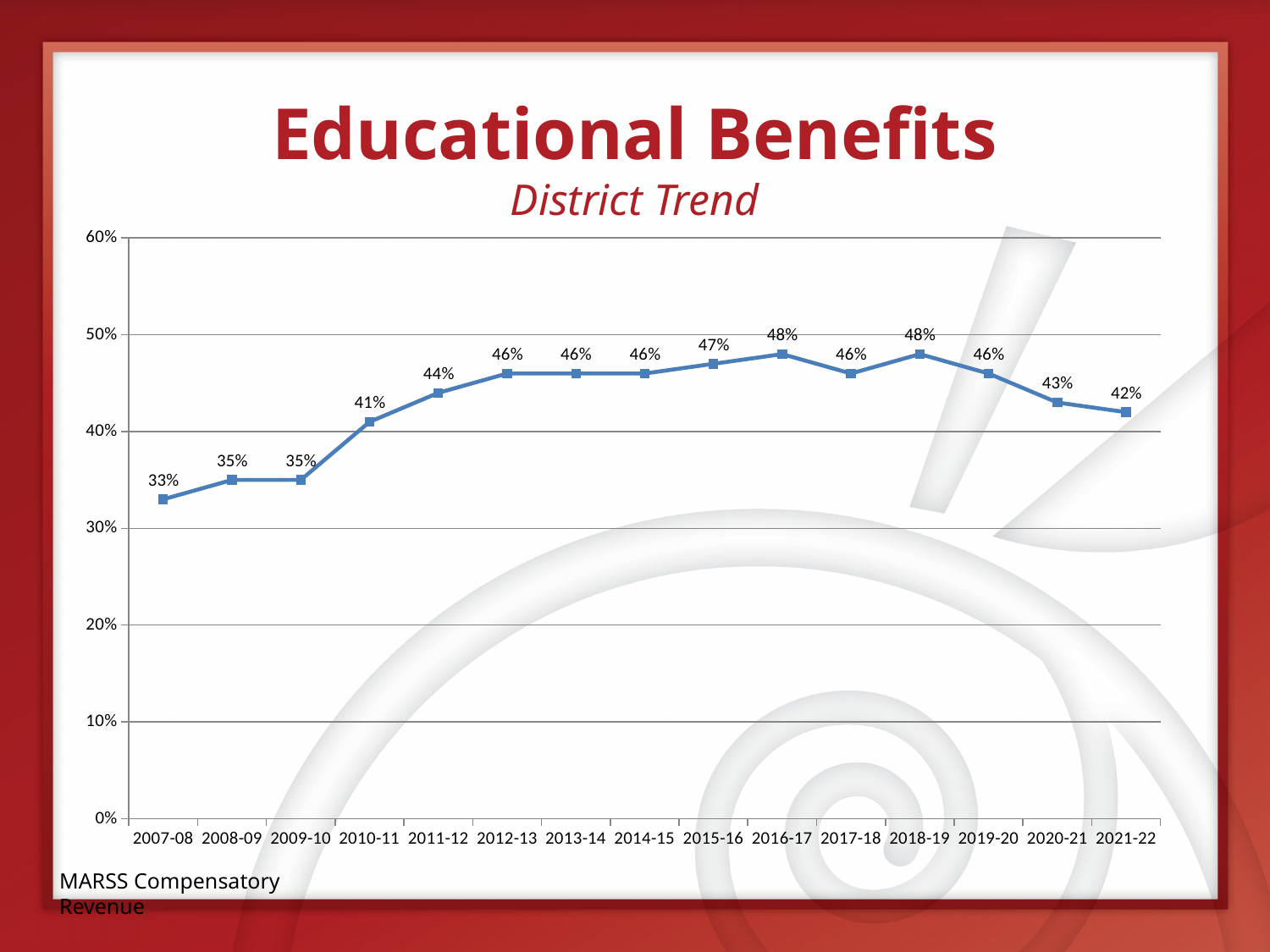
What is the value for 2010-11? 41% Do the values rise or fall from 2007-08 to 2011-12? Rise What is the value for 2021-22? 42% What is the subtitle of the chart below 'Educational Benefits'? District Trend What is the difference between the values for 2018-19 and 2021-22? 6% What is the value for 2016-17? 48% What is the value for 2007-08? 33% How many school years are plotted on the chart? 15 Which is larger, the value for 2011-12 or the value for 2020-21? 2011-12 What kind of chart is shown on the slide? Line chart What is the highest value shown on the chart? 48% Which school year has the lowest value? 2007-08